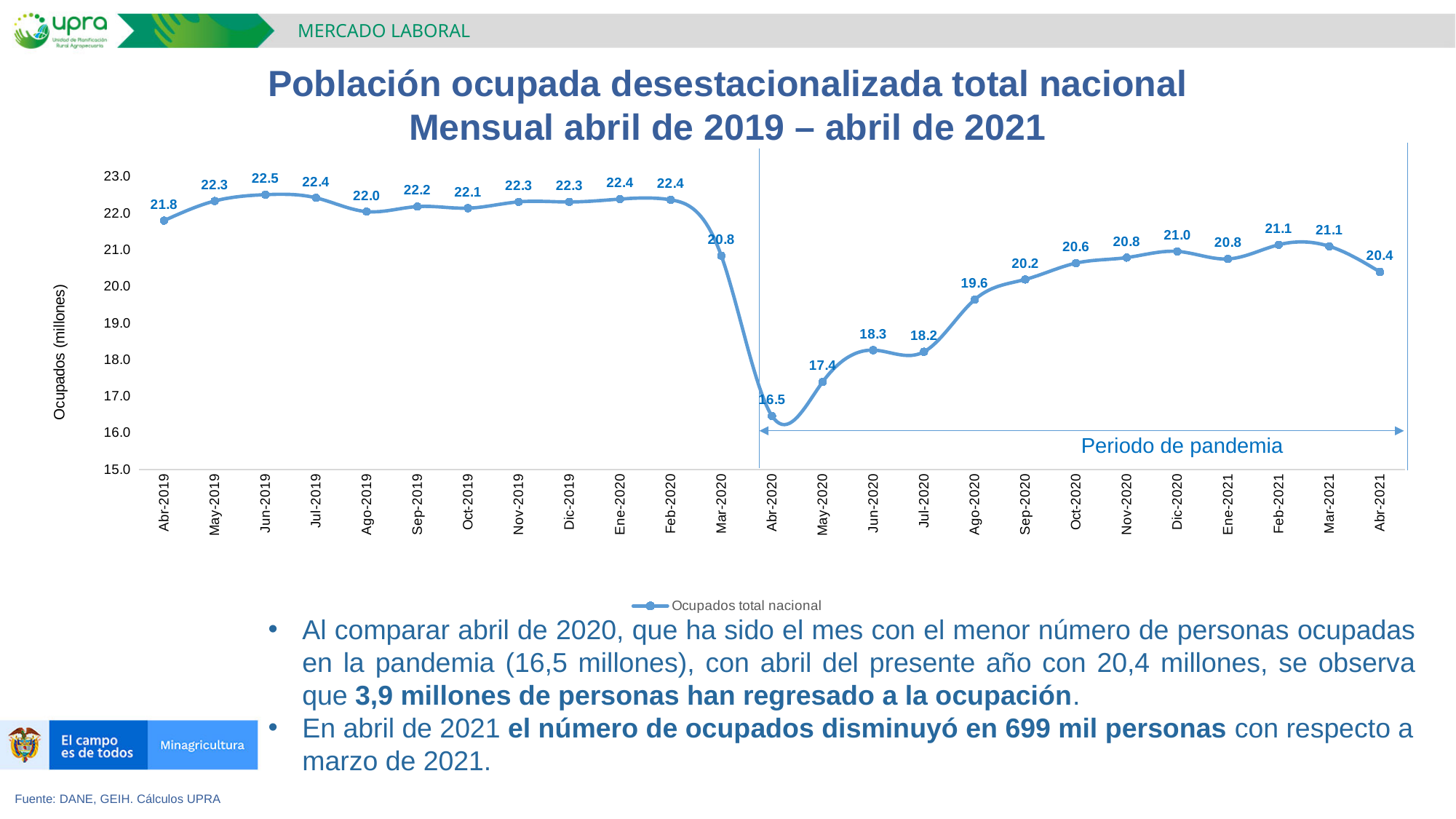
What is the value for Abr-2021? 20.4 What is the value for Abr-2020? 16.5 How many data points are plotted on the chart? 25 What is the difference between the values for Feb-2020 and Mar-2020? 1.6 Which is larger, the value for Ago-2020 or the value for Sep-2020? Sep-2020 Do the values rise or fall from Abr-2020 to Dic-2020? Rise What type of chart is shown on the slide? Line chart Which month has the highest value? Jun-2019 Which month has the lowest value? Abr-2020 How many series does the legend list? 1 What is the difference between the values for Abr-2021 and Abr-2020? 3.9 What is the value for Mar-2020? 20.8